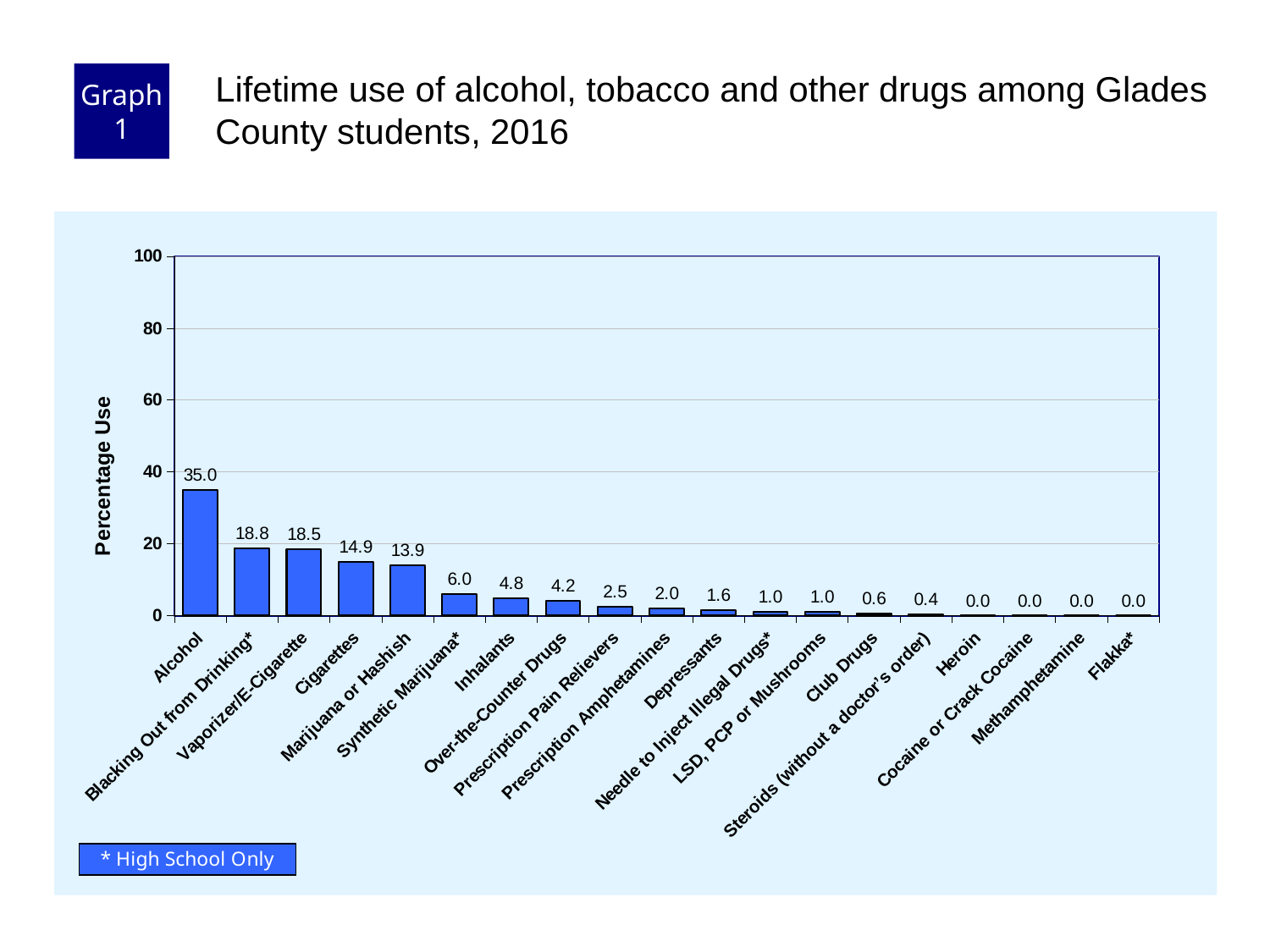
What is the percentage use for Cigarettes? 14.9 What is the difference in percentage use between Alcohol and Blacking Out from Drinking*? 16.2 What is the percentage use for Synthetic Marijuana*? 6.0 What is the label of the y axis? Percentage Use How many categories are shown on the x axis? 19 What is the percentage use for Alcohol? 35.0 Is the value for Alcohol greater or less than 40? less What is the percentage use for Club Drugs? 0.6 Which category has the highest percentage use? Alcohol What kind of chart is shown on the slide? Bar chart What is the difference in percentage use between Marijuana or Hashish and Inhalants? 9.1 Which has a higher percentage use, Vaporizer/E-Cigarette or Cigarettes? Vaporizer/E-Cigarette